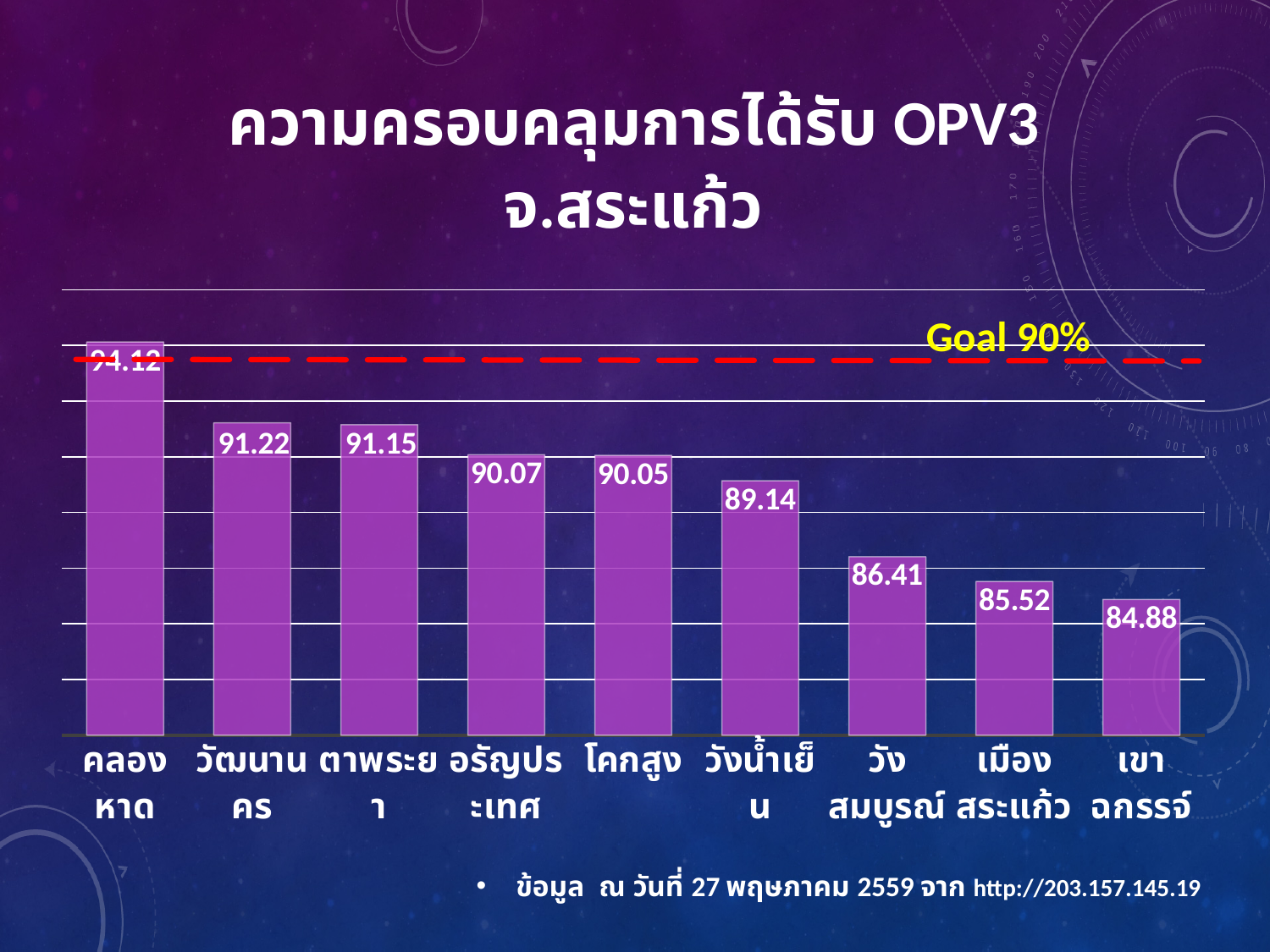
What kind of chart is shown on the slide? bar chart What is the difference between the values for อรัญประเทศ and โคกสูง? 0.02 What is the value for คลองหาด? 94.12 What is the value for เมืองสระแก้ว? 85.52 Which is larger, the value for วังสมบูรณ์ or the value for โคกสูง? โคกสูง Which category has the highest value? คลองหาด Do the values rise or fall from left to right across the categories? fall What goal value is marked by the red dashed line? 90% Which category has the lowest value? เขาฉกรรจ์ How many categories are shown in the chart? 9 What is the difference between the values for วัฒนานคร and เขาฉกรรจ์? 6.34 What is the value for วังน้ำเย็น? 89.14